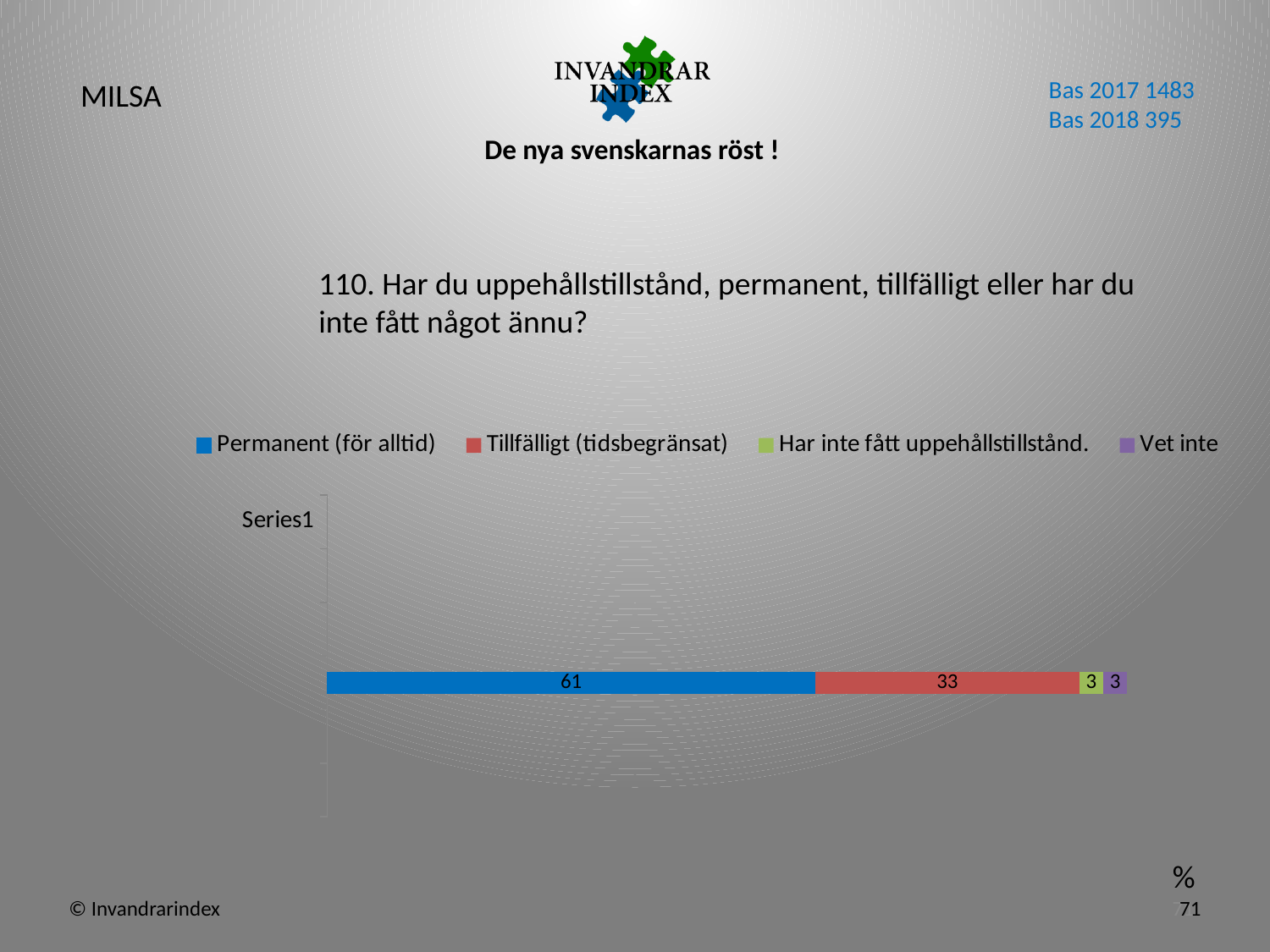
What is the difference between the values for Permanent (för alltid) and Tillfälligt (tidsbegränsat)? 28 Which legend entry has the highest value in the bar? Permanent (för alltid) What is the label of the category on the vertical axis? Series1 What is the value for Vet inte? 3 What is the total of the stacked bar for Series1? 100 What is the value for Har inte fått uppehållstillstånd.? 3 How many series does the legend list? 4 What is the value for Tillfälligt (tidsbegränsat)? 33 Which is larger, the value for Tillfälligt (tidsbegränsat) or the value for Vet inte? Tillfälligt (tidsbegränsat) What is the value for Permanent (för alltid)? 61 What kind of chart is shown on the slide? Stacked bar chart Which colour represents Permanent (för alltid) in the legend? Blue